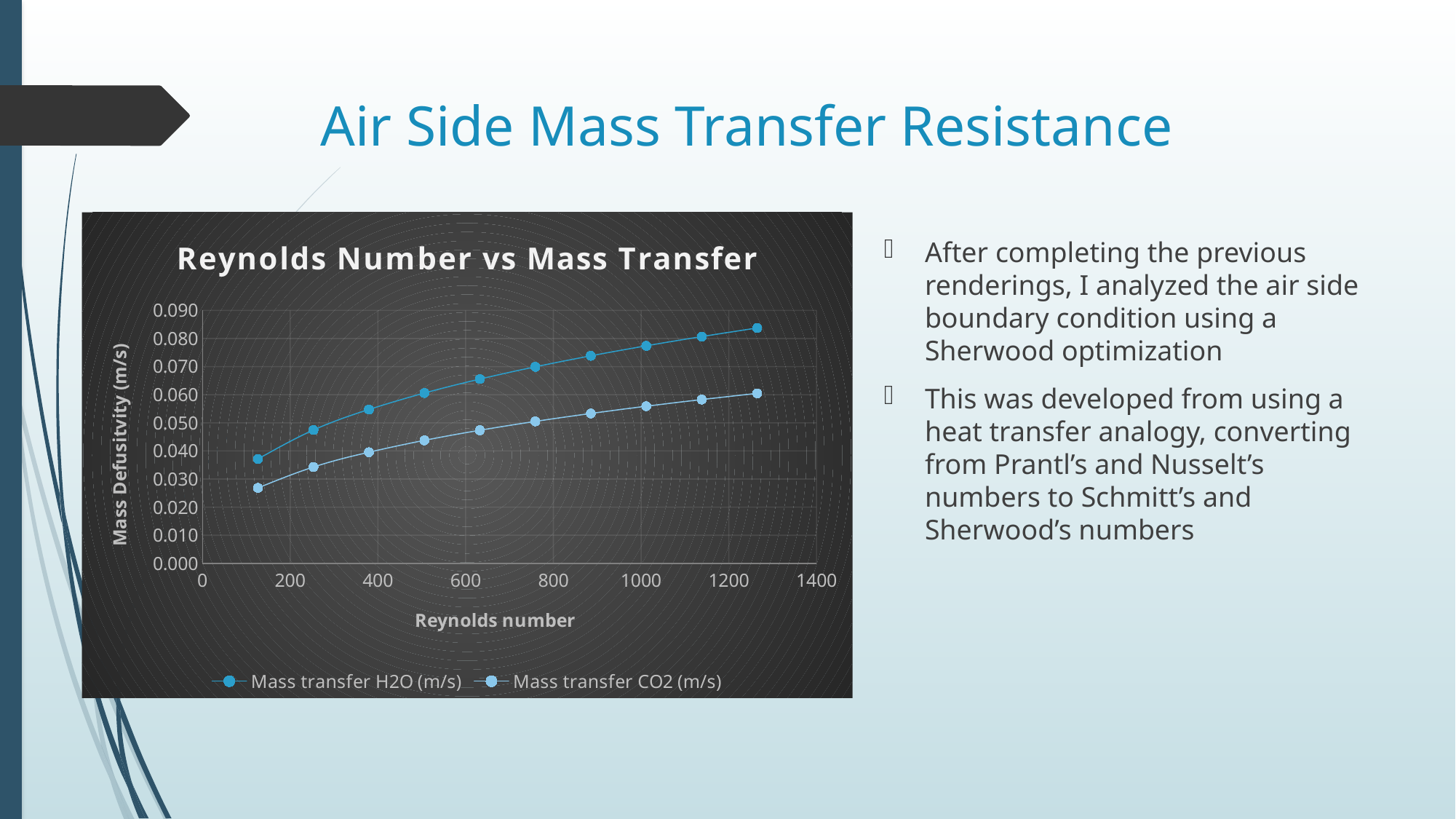
Is the lowest Mass transfer H2O (m/s) value (at the smallest Reynolds number) greater or less than 0.040? less How many series does the chart legend list? 2 Is the Mass transfer CO2 (m/s) value at a Reynolds number of about 600 greater or less than 0.050? less How many data points are plotted for the Mass transfer H2O (m/s) series? 10 Is the lowest Mass transfer CO2 (m/s) value (at the smallest Reynolds number) greater or less than 0.030? less What kind of chart is shown on the slide? Line chart (scatter with lines) Do the Mass transfer CO2 (m/s) values rise or fall as the Reynolds number increases? Rise Do the Mass transfer H2O (m/s) values rise or fall as the Reynolds number increases? Rise What is the label of the x axis? Reynolds number Which series has the higher values across the plotted Reynolds numbers, Mass transfer H2O (m/s) or Mass transfer CO2 (m/s)? Mass transfer H2O (m/s) What is the title of the chart? Reynolds Number vs Mass Transfer